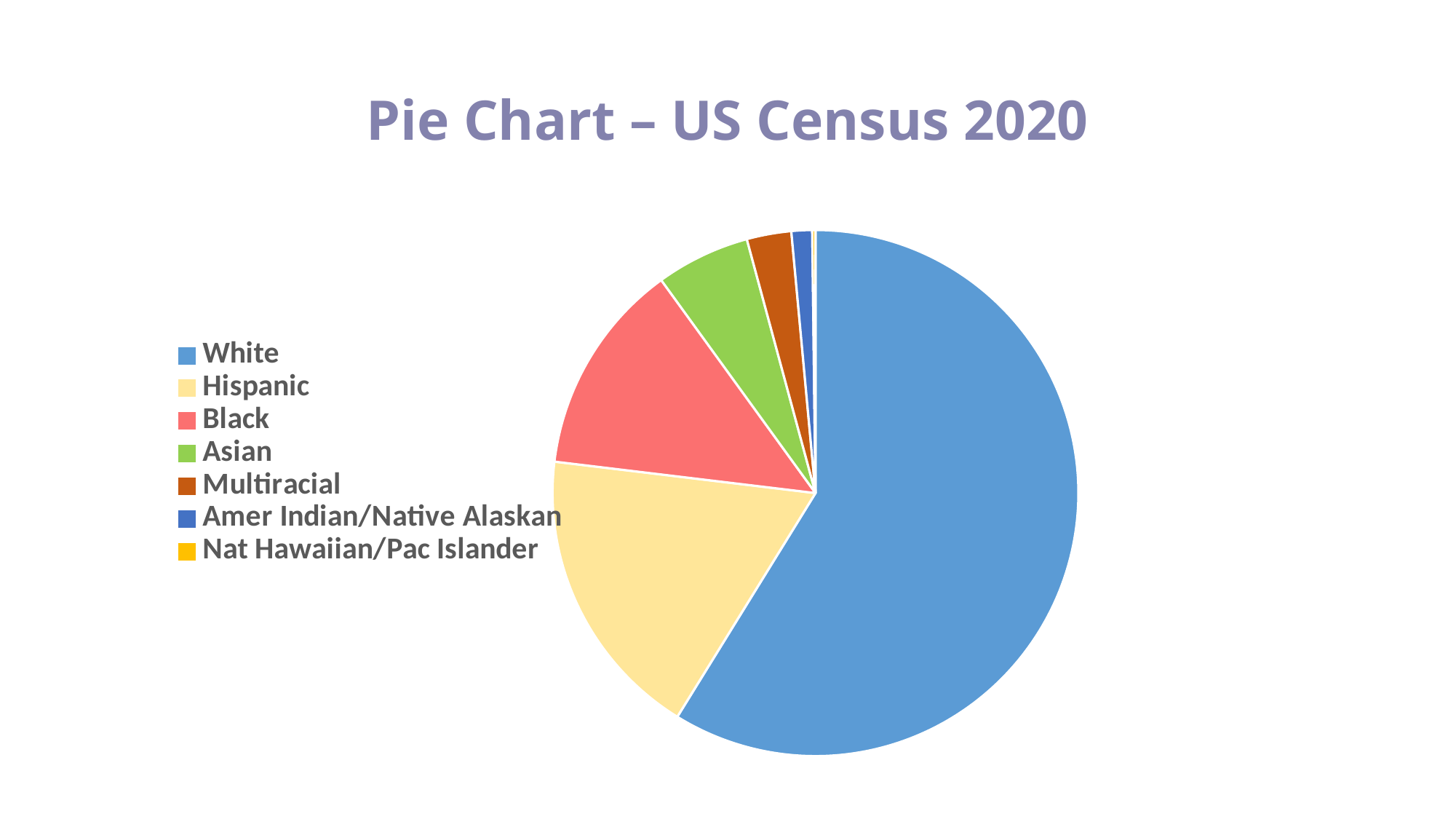
Which category has the largest slice of the pie? White Which category has the smallest slice of the pie? Nat Hawaiian/Pac Islander Which slice is larger, Black or Asian? Black Which slice is larger, Hispanic or Black? Hispanic Which colour represents the Asian category in the legend? green Which category has the second largest slice of the pie? Hispanic Which slice is larger, White or Hispanic? White What kind of chart is shown on the slide? pie chart How many categories does the pie chart's legend list? 7 What is the title of the chart? Pie Chart – US Census 2020